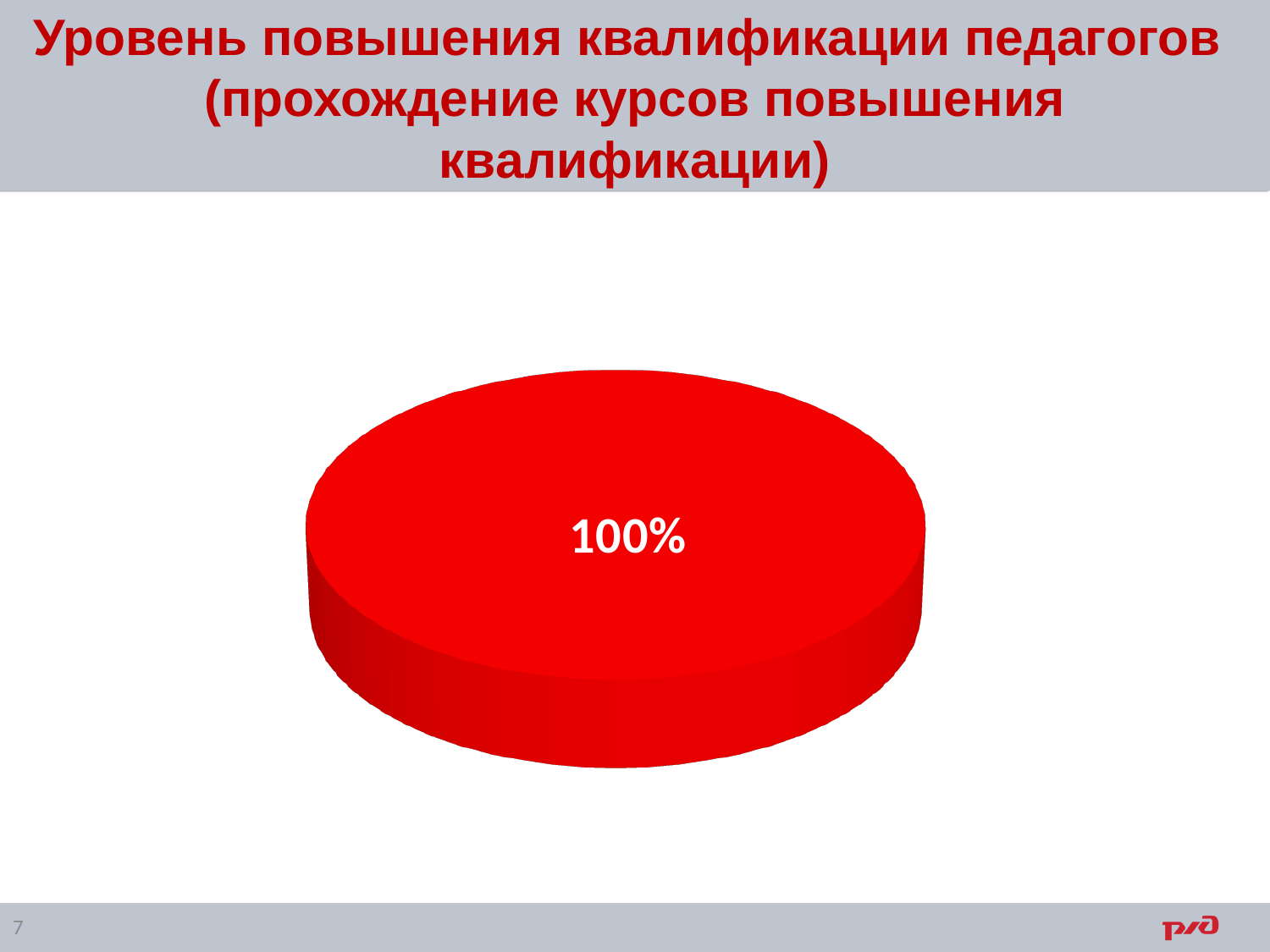
What colour is the slice of the pie chart? red How many slices does the pie chart have? 1 Is the value shown on the pie chart greater or less than 50%? greater What share of the pie does the single slice take up? 100% What kind of chart is shown on the slide? pie chart What percentage is printed on the pie chart's slice? 100% Does the pie chart include a legend? No